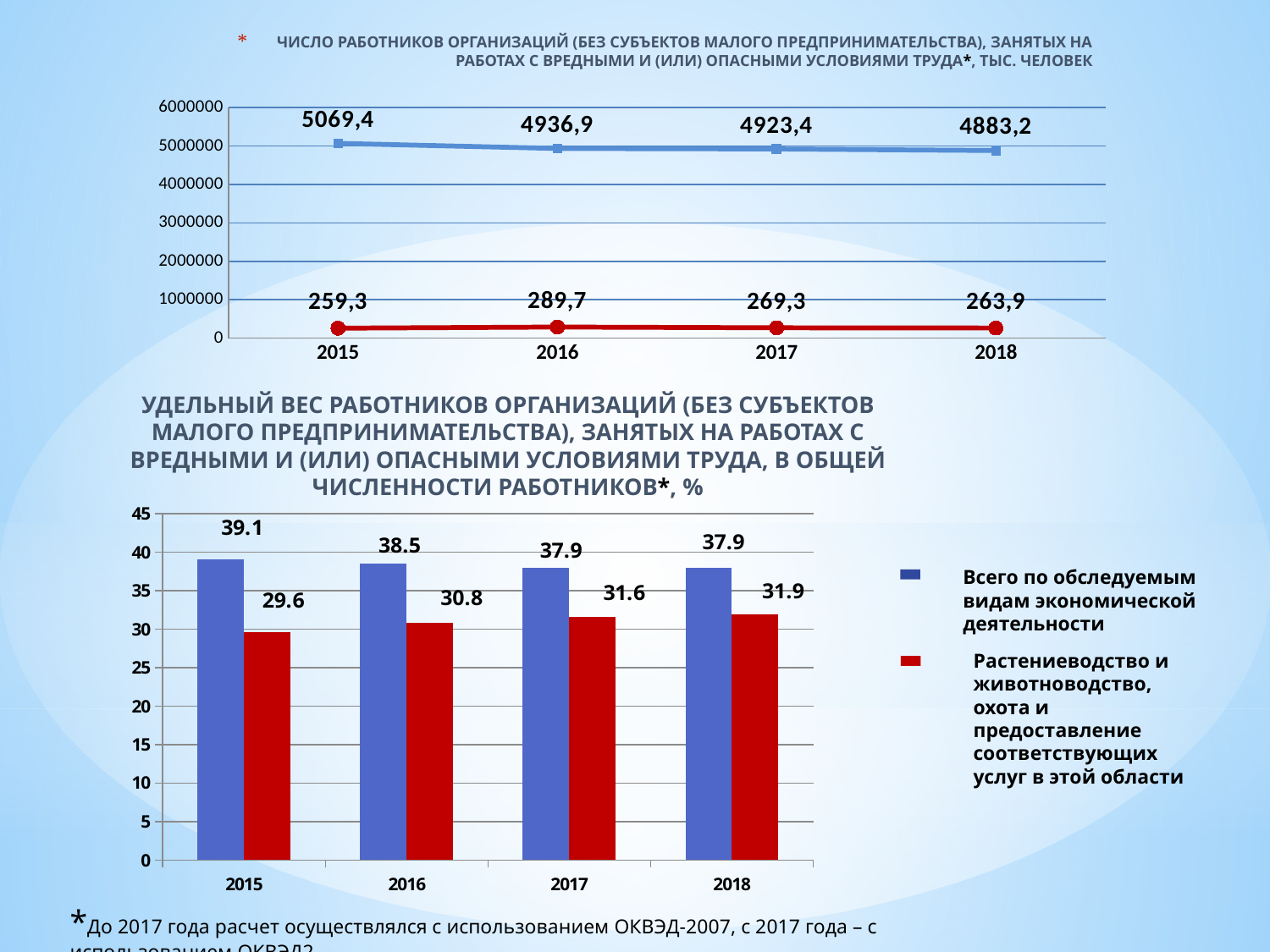
In the top line chart, how many years are shown on the x axis? 4 In the bottom bar chart, does the red series rise or fall from 2015 to 2018? rise In the top line chart, does the blue series rise or fall from 2015 to 2018? fall In the top line chart, what is the value of the red series for 2016? 289,7 In the top line chart, in which year is the red series highest? 2016 In the bottom bar chart, what is the value for 'Растениеводство и животноводство, охота и предоставление соответствующих услуг в этой области' in 2018? 31.9 In the bottom bar chart, what is the value for 'Всего по обследуемым видам экономической деятельности' in 2016? 38.5 How many series does the legend of the bottom bar chart list? 2 In the top line chart, in which year is the blue series lowest? 2018 What kind of chart is the top chart on the slide? line chart In the top line chart, what is the value of the blue series for 2015? 5069,4 In the bottom bar chart, what is the difference between the two series in 2015? 9.5